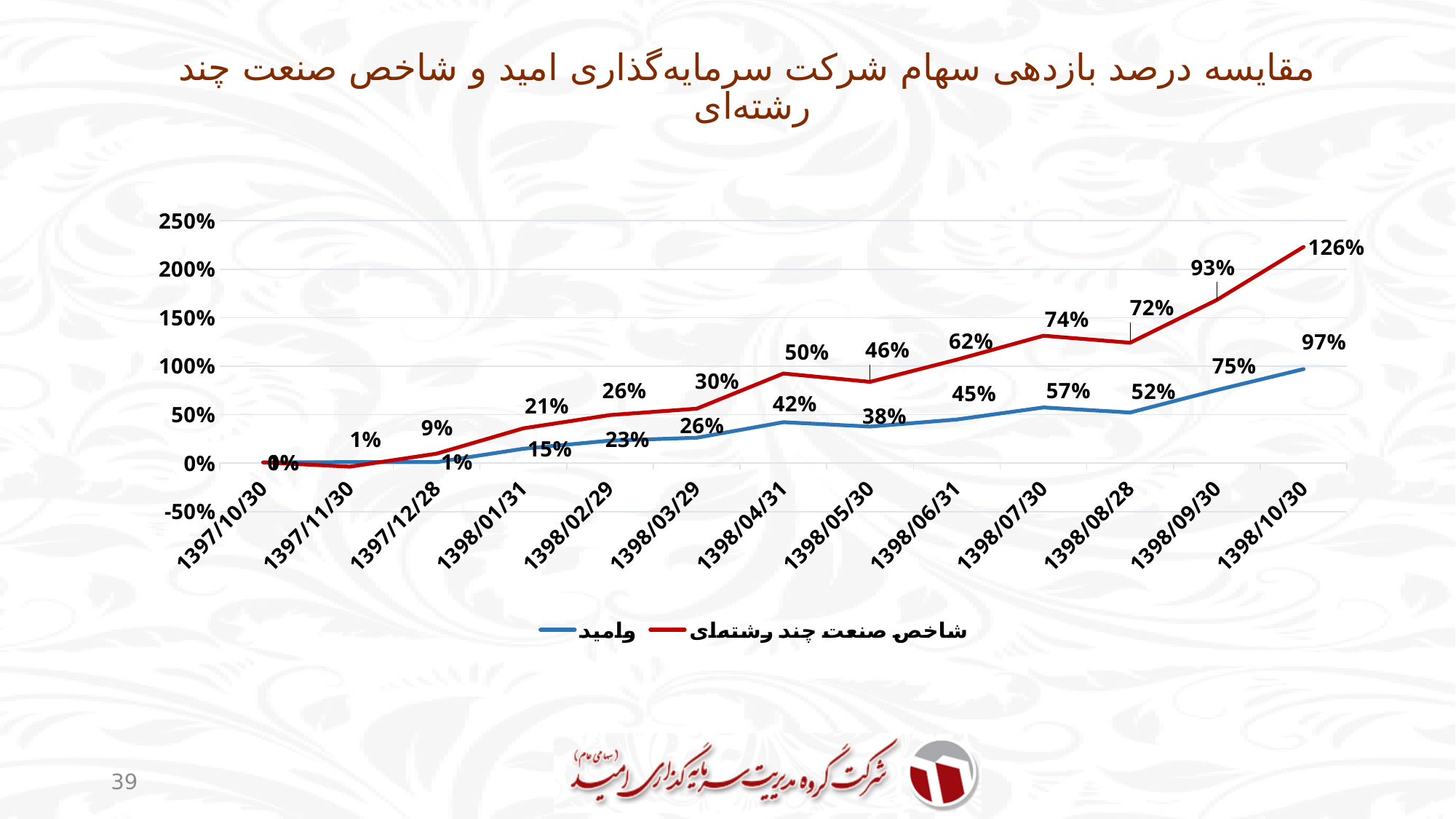
What is the value of the وامید series at 1398/09/30? 75% What is the difference between the شاخص صنعت چند رشته‌ای value and the وامید value at 1398/10/30? 29 percentage points What is the value of the وامید series at 1398/10/30? 97% Do the values of the وامید series generally rise or fall from 1397/10/30 to 1398/10/30? Rise What is the value of the شاخص صنعت چند رشته‌ای series at 1398/07/30? 74% How many dates are plotted along the x axis? 13 At 1398/08/28, which series has the larger value, وامید or شاخص صنعت چند رشته‌ای? شاخص صنعت چند رشته‌ای What is the value of the شاخص صنعت چند رشته‌ای series at 1398/10/30? 126% What kind of chart is shown on the slide? Line chart How many series does the legend list? 2 At which date does the شاخص صنعت چند رشته‌ای series reach its highest value? 1398/10/30 What is the value of the وامید series at 1398/04/31? 42%